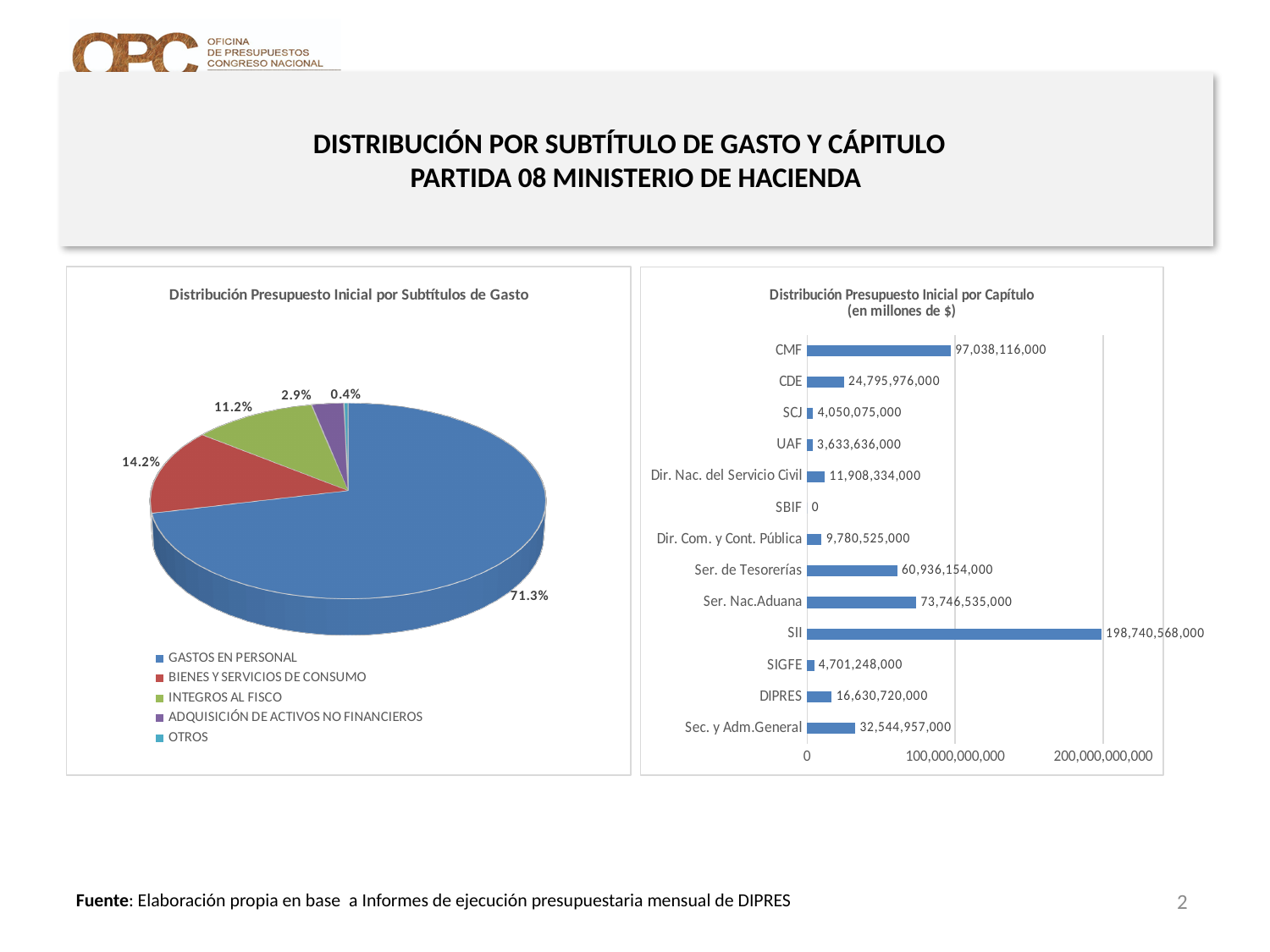
In the chart 'Distribución Presupuesto Inicial por Capítulo', what is the difference between the values for CMF and Ser. Nac.Aduana? 23,291,581,000 In the chart 'Distribución Presupuesto Inicial por Subtítulos de Gasto', which category has the smallest slice? OTROS In the chart 'Distribución Presupuesto Inicial por Subtítulos de Gasto', what share of the pie does BIENES Y SERVICIOS DE CONSUMO have? 14.2% In the chart 'Distribución Presupuesto Inicial por Capítulo', what is the value for SII? 198,740,568,000 In the chart 'Distribución Presupuesto Inicial por Capítulo', which category has the lowest value? SBIF In the chart 'Distribución Presupuesto Inicial por Subtítulos de Gasto', how many categories does the legend list? 5 In the chart 'Distribución Presupuesto Inicial por Capítulo', which is larger, the value for DIPRES or the value for CDE? CDE In the chart 'Distribución Presupuesto Inicial por Capítulo', what is the value for Ser. de Tesorerías? 60,936,154,000 In the chart 'Distribución Presupuesto Inicial por Subtítulos de Gasto', what share of the pie does GASTOS EN PERSONAL have? 71.3% What kind of chart is 'Distribución Presupuesto Inicial por Subtítulos de Gasto'? Pie chart What kind of chart is 'Distribución Presupuesto Inicial por Capítulo'? Bar chart In the chart 'Distribución Presupuesto Inicial por Capítulo', which category has the highest value? SII